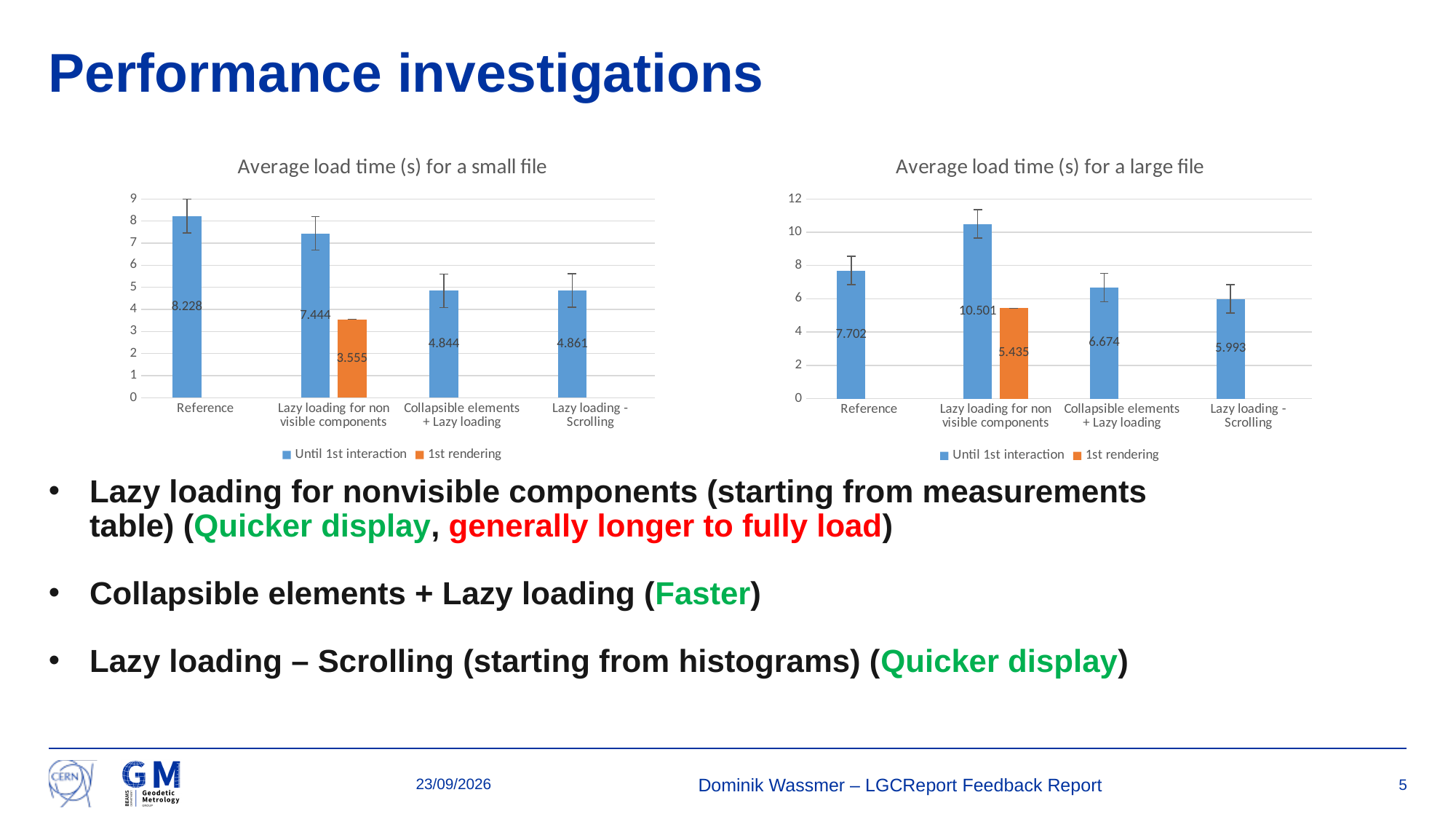
How many series does the legend of the 'Average load time (s) for a large file' chart list? 2 In the 'Average load time (s) for a large file' chart, what is the difference between the 'Until 1st interaction' values for 'Lazy loading for non visible components' and Reference? 2.799 In the 'Average load time (s) for a small file' chart, what is the '1st rendering' value for 'Lazy loading for non visible components'? 3.555 In the 'Average load time (s) for a small file' chart, what is the 'Until 1st interaction' value for Reference? 8.228 In the 'Average load time (s) for a large file' chart, what is the '1st rendering' value for 'Lazy loading for non visible components'? 5.435 In the 'Average load time (s) for a large file' chart, which category has the lowest 'Until 1st interaction' value? Lazy loading - Scrolling In the 'Average load time (s) for a large file' chart, what is the 'Until 1st interaction' value for 'Lazy loading for non visible components'? 10.501 In the 'Average load time (s) for a large file' chart, which category has the highest 'Until 1st interaction' value? Lazy loading for non visible components In the 'Average load time (s) for a small file' chart, which category has the highest 'Until 1st interaction' value? Reference In the 'Average load time (s) for a small file' chart, what is the difference between the 'Until 1st interaction' values for Reference and 'Lazy loading for non visible components'? 0.784 How many categories are shown on the x axis of the 'Average load time (s) for a small file' chart? 4 In the 'Average load time (s) for a large file' chart, which is larger: the 'Until 1st interaction' value for Reference or for 'Collapsible elements + Lazy loading'? Reference